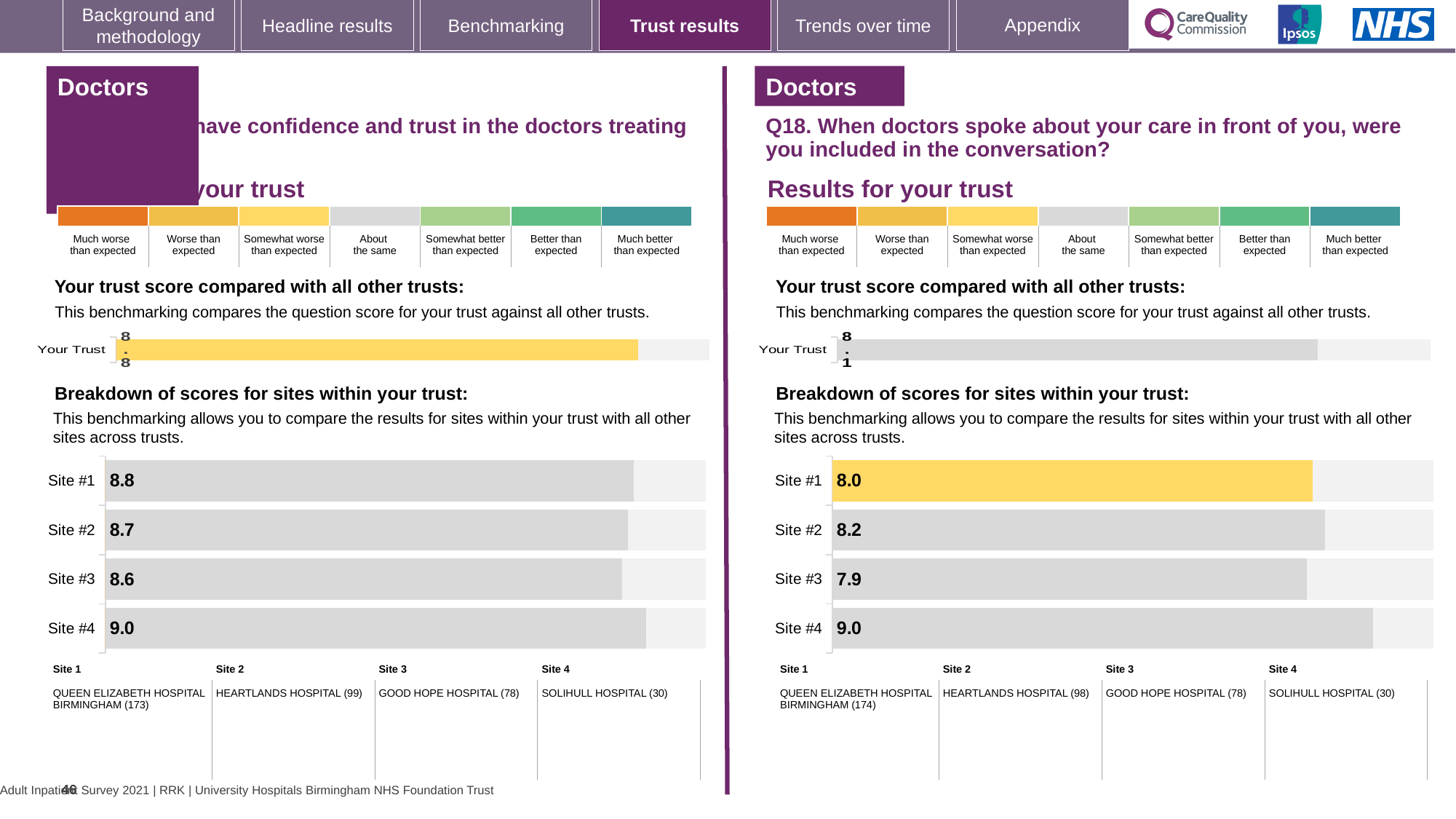
In the left-hand chart, what is the score for Site #2? 8.7 In the right-hand chart (Q18), which site has the highest score? Site #4 In the right-hand chart (Q18), what is the difference between the scores for Site #4 and Site #3? 1.1 In the right-hand chart (Q18), what is the 'Your Trust' score? 8.1 In the right-hand chart (Q18), which has the higher score, Site #2 or Site #1? Site #2 In the right-hand chart (Q18), which site has the lowest score? Site #3 In the left-hand chart, what is the 'Your Trust' score? 8.8 In the left-hand chart, which site has the lowest score? Site #3 In the left-hand chart, what is the difference between the scores for Site #4 and Site #1? 0.2 In the right-hand chart (Q18), what is the score for Site #3? 7.9 In the right-hand chart (Q18), what is the score for Site #1? 8.0 How many sites are shown in the site breakdown chart on the right-hand side (Q18)? 4